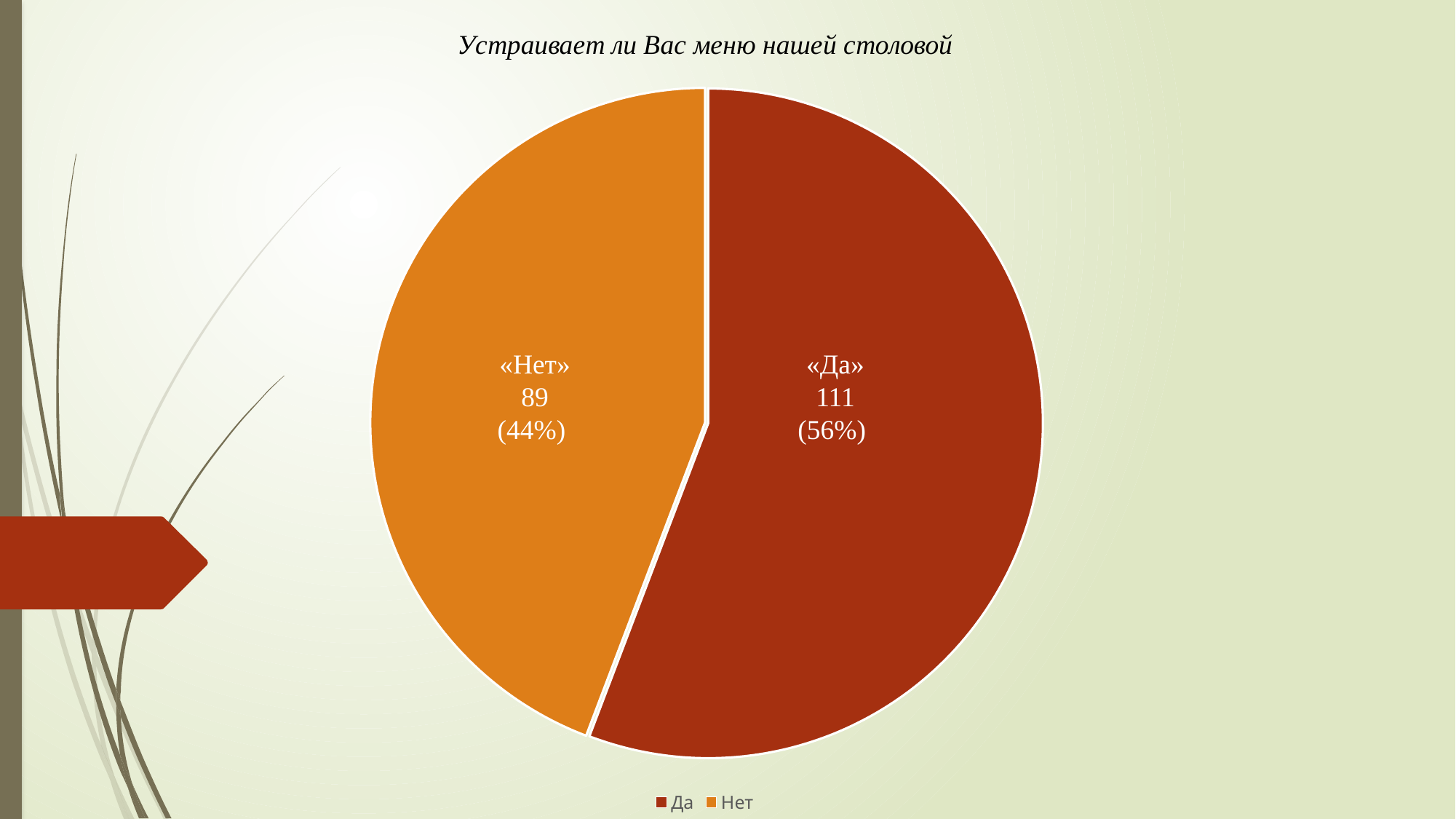
What is the difference between the values for «Да» and «Нет»? 22 How many slices does the pie chart have? 2 What share of the pie does «Нет» represent? 44% How many entries does the legend list? 2 What share of the pie does «Да» represent? 56% Which slice is the smallest? «Нет» Which slice is the largest? «Да» What is the value for «Нет»? 89 What is the title of the chart? Устраивает ли Вас меню нашей столовой What kind of chart is shown on the slide? pie chart What is the value for «Да»? 111 What is the total of the two slices? 200